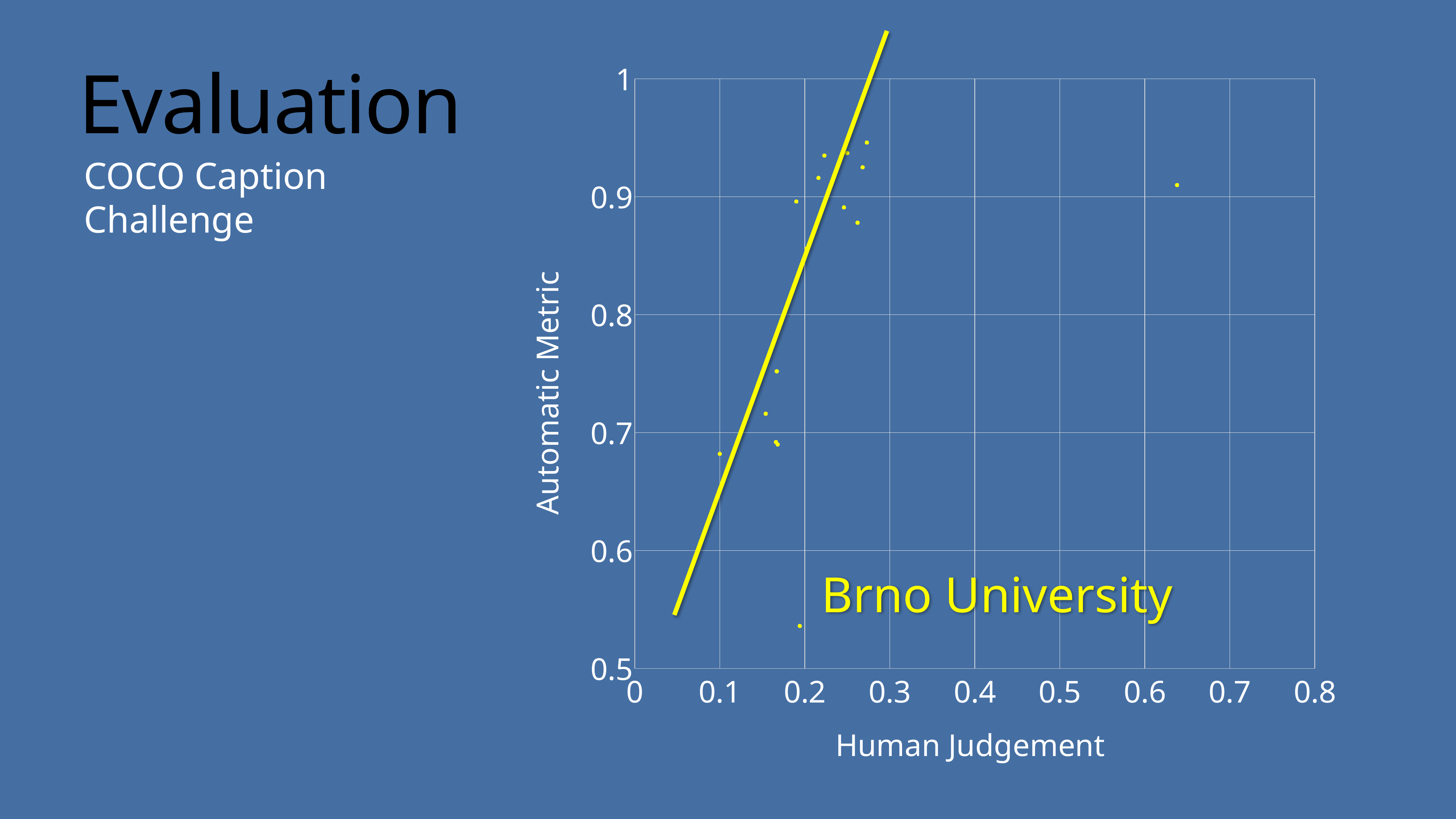
Does the trend line in the chart rise or fall as Human Judgement increases? Rises Is the Automatic Metric value of the rightmost point in the chart greater or less than 0.9? greater Is the Human Judgement value of the rightmost point in the chart greater or less than 0.5? greater What is the title of the vertical axis of the chart? Automatic Metric What is the highest value shown on the horizontal axis of the chart? 0.8 Which point has the higher Automatic Metric value: the rightmost point or the lowest point? The rightmost point Is the Human Judgement value of the leftmost point in the chart greater or less than 0.2? less What kind of chart is shown on the slide? Scatter plot What is the lowest value shown on the vertical axis of the chart? 0.5 What is the title of the horizontal axis of the chart? Human Judgement